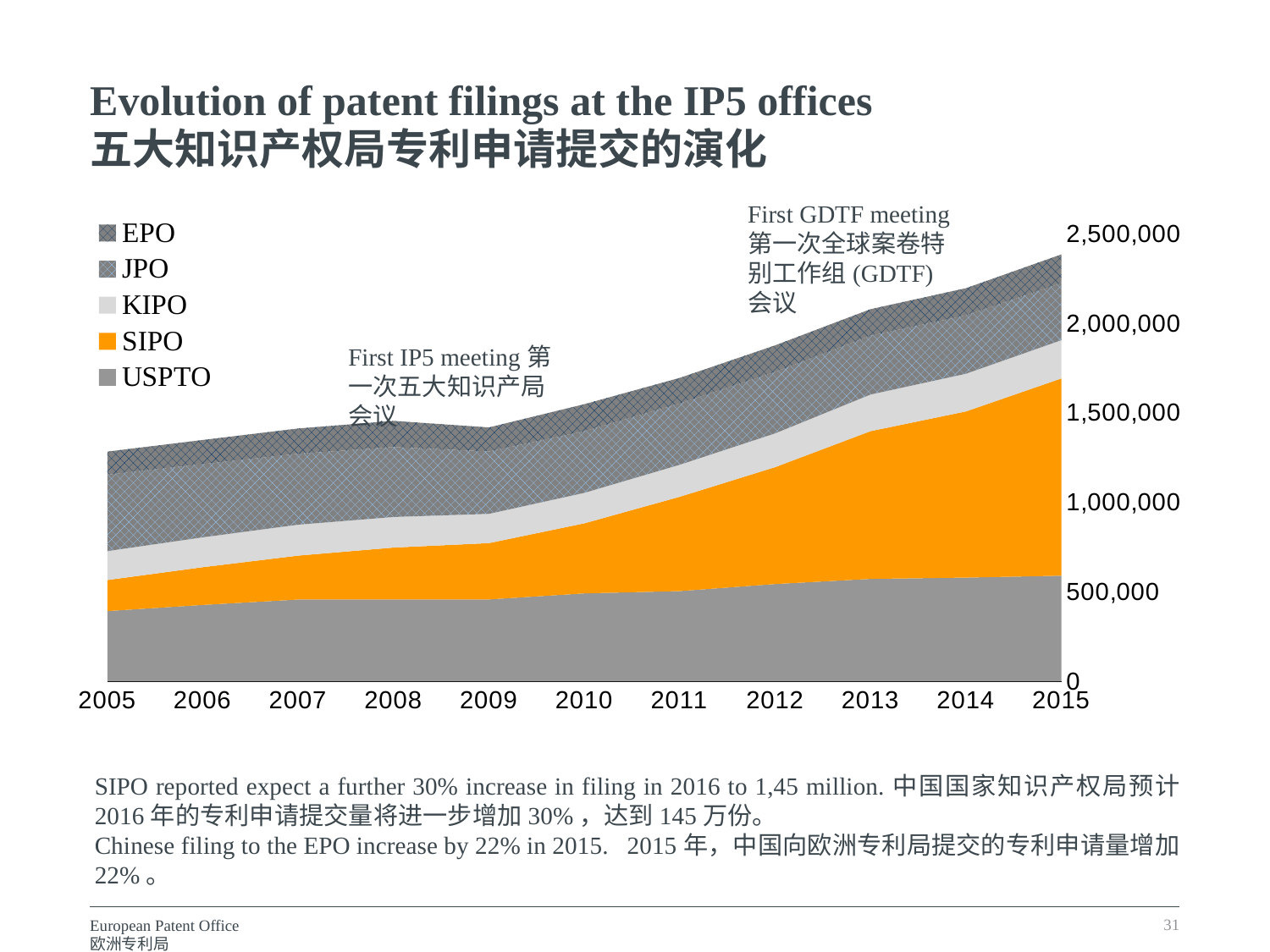
Which office has the largest share of filings in 2015? SIPO Is the value for USPTO in 2005 greater or less than 500,000? less What is the last year shown on the x axis? 2015 What kind of chart is shown on the slide? stacked area chart What is the first year shown on the x axis? 2005 Which series is shown in orange? SIPO Is the total of patent filings at the IP5 offices in 2015 greater or less than 2,000,000? greater Is the total of patent filings at the IP5 offices in 2005 greater or less than 1,500,000? less Does the total of patent filings rise or fall from 2005 to 2015? rise How many years are shown along the x axis? 11 How many series does the legend list? 5 In 2015, which is larger, the SIPO filings or the USPTO filings? SIPO